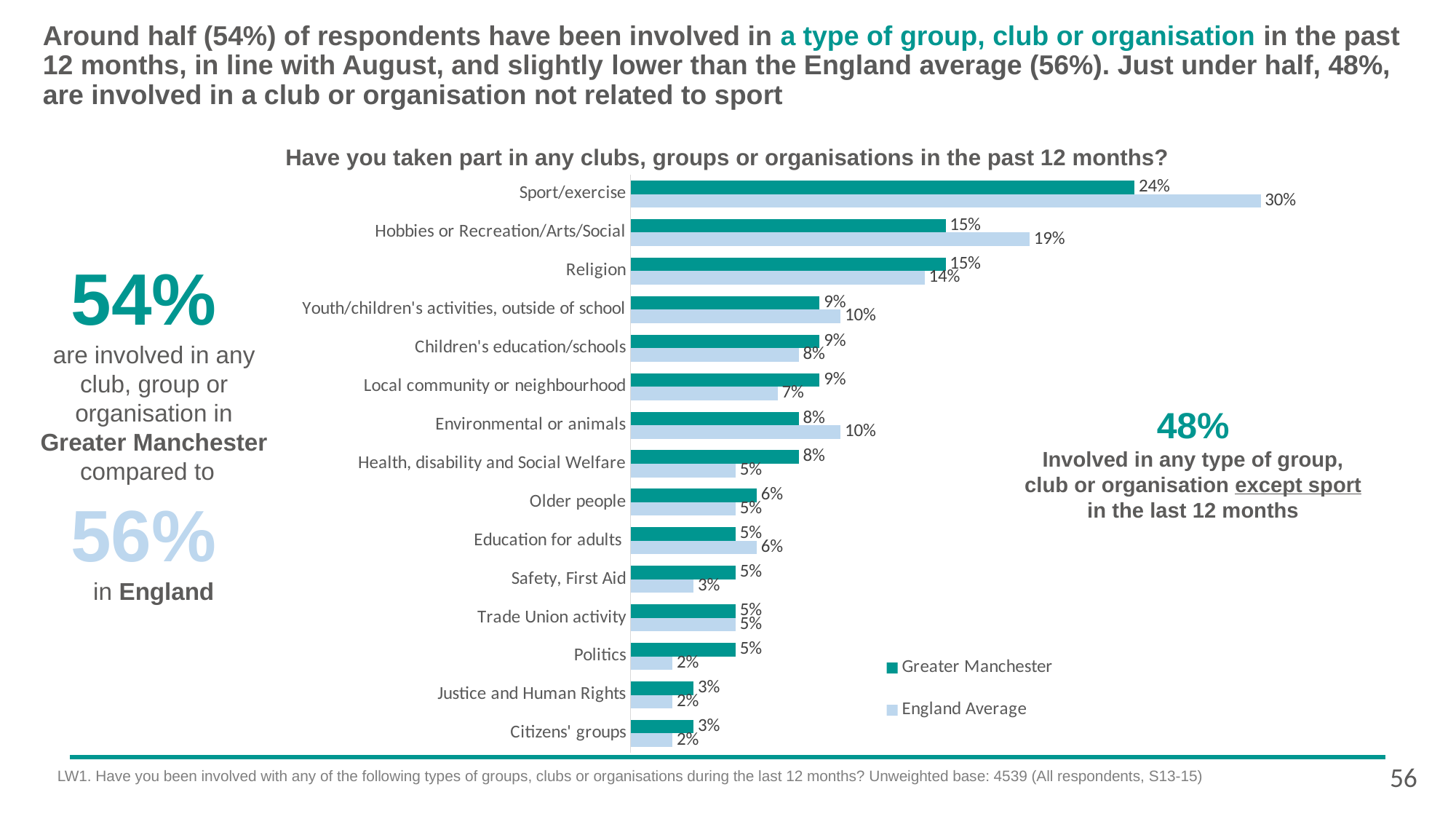
What is the Greater Manchester value for Sport/exercise? 24% What is the England Average value for Health, disability and Social Welfare? 5% What is the difference between the England Average and Greater Manchester values for Sport/exercise? 6% How many categories are shown in the chart? 15 What is the title of the chart? Have you taken part in any clubs, groups or organisations in the past 12 months? Which is larger for Environmental or animals: the Greater Manchester value or the England Average value? England Average Which category has the highest England Average value? Sport/exercise What kind of chart is shown on the slide? Bar chart Which is larger for Politics: the Greater Manchester value or the England Average value? Greater Manchester What is the England Average value for Hobbies or Recreation/Arts/Social? 19% Which category has the lowest Greater Manchester value? Justice and Human Rights and Citizens' groups (both 3%) How many series does the legend list? 2